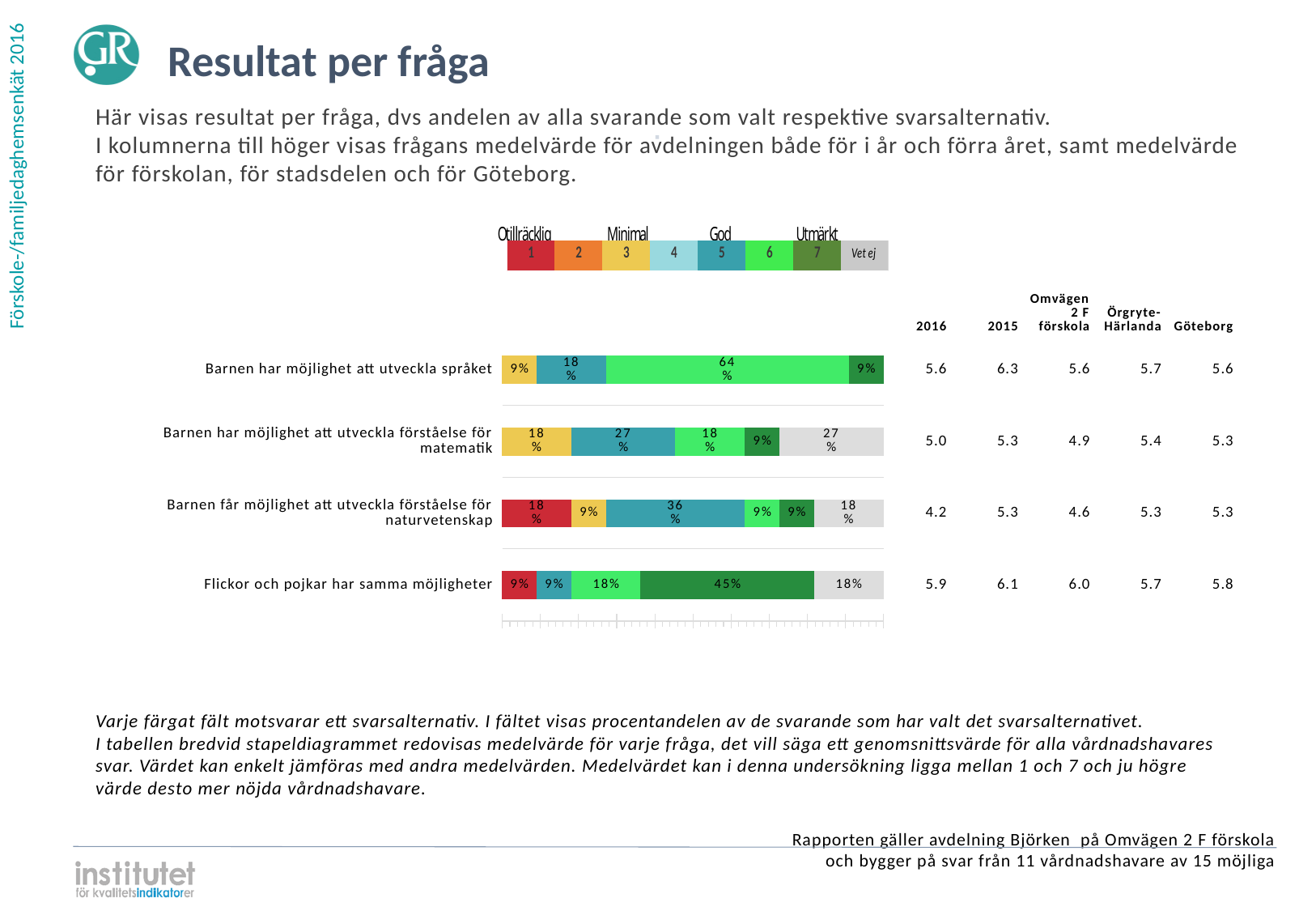
What percentage chose 'Vet ej' for 'Barnen har möjlighet att utveckla förståelse för matematik'? 27% What is the difference between the share for alternative 5 and the share for alternative 6 in 'Barnen har möjlighet att utveckla förståelse för matematik'? 9% What kind of chart is shown on the slide? Stacked bar chart Which question has the highest 2016 mean value in the table next to the chart? Flickor och pojkar har samma möjligheter (5.9) What is the 2016 mean value shown for 'Barnen får möjlighet att utveckla förståelse för naturvetenskap'? 4.2 What percentage chose answer alternative 7 (Utmärkt) for 'Flickor och pojkar har samma möjligheter'? 45% Which is larger for 'Flickor och pojkar har samma möjligheter': the share for alternative 6 or the share for alternative 7? Alternative 7 (45%) Which answer alternative has the largest share for 'Barnen får möjlighet att utveckla förståelse för naturvetenskap'? 5 (God), 36% How many answer alternatives does the legend above the chart list? 8 How many questions (categories) are plotted in the bar chart? 4 What percentage of respondents chose answer alternative 6 for 'Barnen har möjlighet att utveckla språket'? 64% What percentage chose answer alternative 1 (Otillräcklig) for 'Barnen får möjlighet att utveckla förståelse för naturvetenskap'? 18%